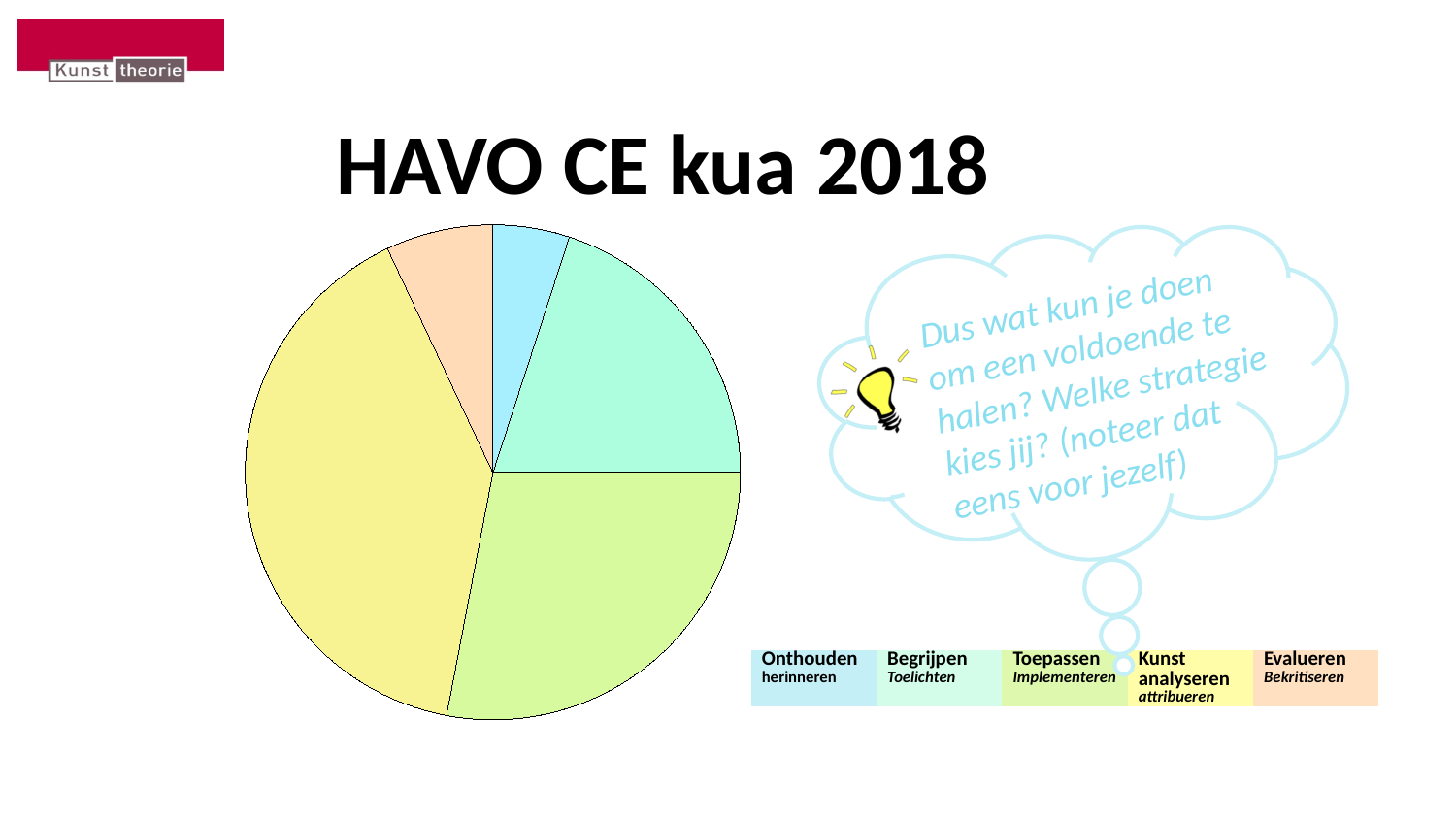
Which category has the largest slice in the pie chart? Kunst analyseren Which colour represents Onthouden in the pie chart? light blue How many entries does the legend of the pie chart list? 5 What is the title of the slide with the pie chart? HAVO CE kua 2018 How many slices does the pie chart have? 5 Which slice is larger, Begrijpen or Evalueren? Begrijpen What kind of chart is shown on the slide? pie chart Which slice is larger, Toepassen or Begrijpen? Toepassen Which slice is larger, Begrijpen or Onthouden? Begrijpen